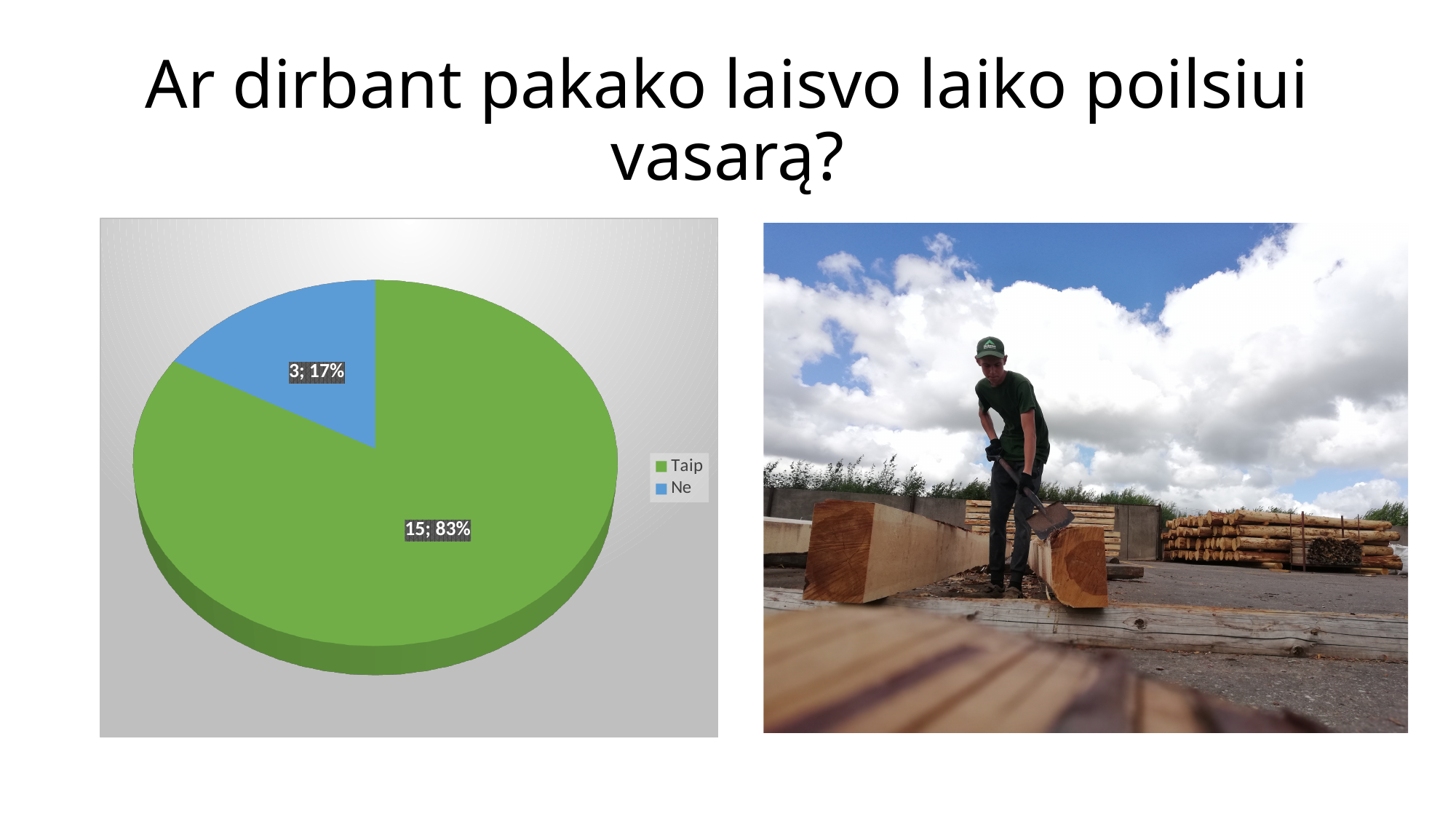
Which category has the largest slice of the pie? Taip What percentage of the pie does the "Ne" slice represent? 17% What is the difference between the number of "Taip" and "Ne" responses? 12 Which is larger, the "Taip" slice or the "Ne" slice? Taip What colour is the "Ne" slice in the pie chart? blue Which category has the smallest slice of the pie? Ne How many respondents answered "Ne"? 3 How many categories does the pie chart have? 2 What kind of chart is shown on the slide? pie chart What percentage of the pie does the "Taip" slice represent? 83% What is the total number of responses shown in the pie chart? 18 How many respondents answered "Taip"? 15